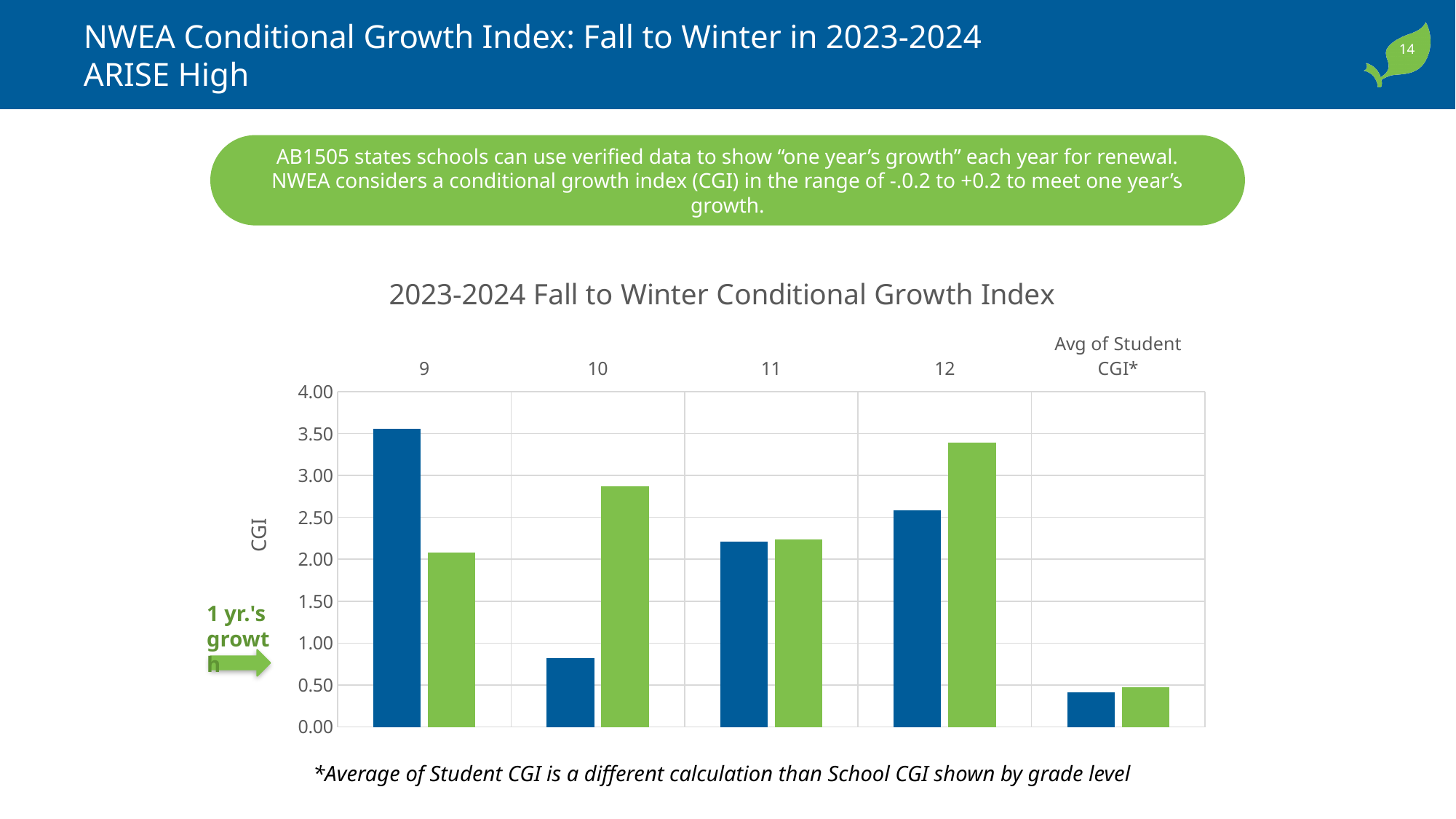
What is the title of the chart? 2023-2024 Fall to Winter Conditional Growth Index Is the green bar for grade 12 greater or less than 3.00? greater Which category has the tallest green bar? 12 For grade 9, which bar is taller, the blue bar or the green bar? blue What is the label of the y axis of the chart? CGI Which category has the tallest blue bar? 9 Is the blue bar for grade 9 greater or less than 3.00? greater For grade 10, which bar is taller, the blue bar or the green bar? green What kind of chart is shown on the slide? bar chart How many categories are shown along the x axis of the chart? 5 Is the green bar for Avg of Student CGI* greater or less than 1.00? less